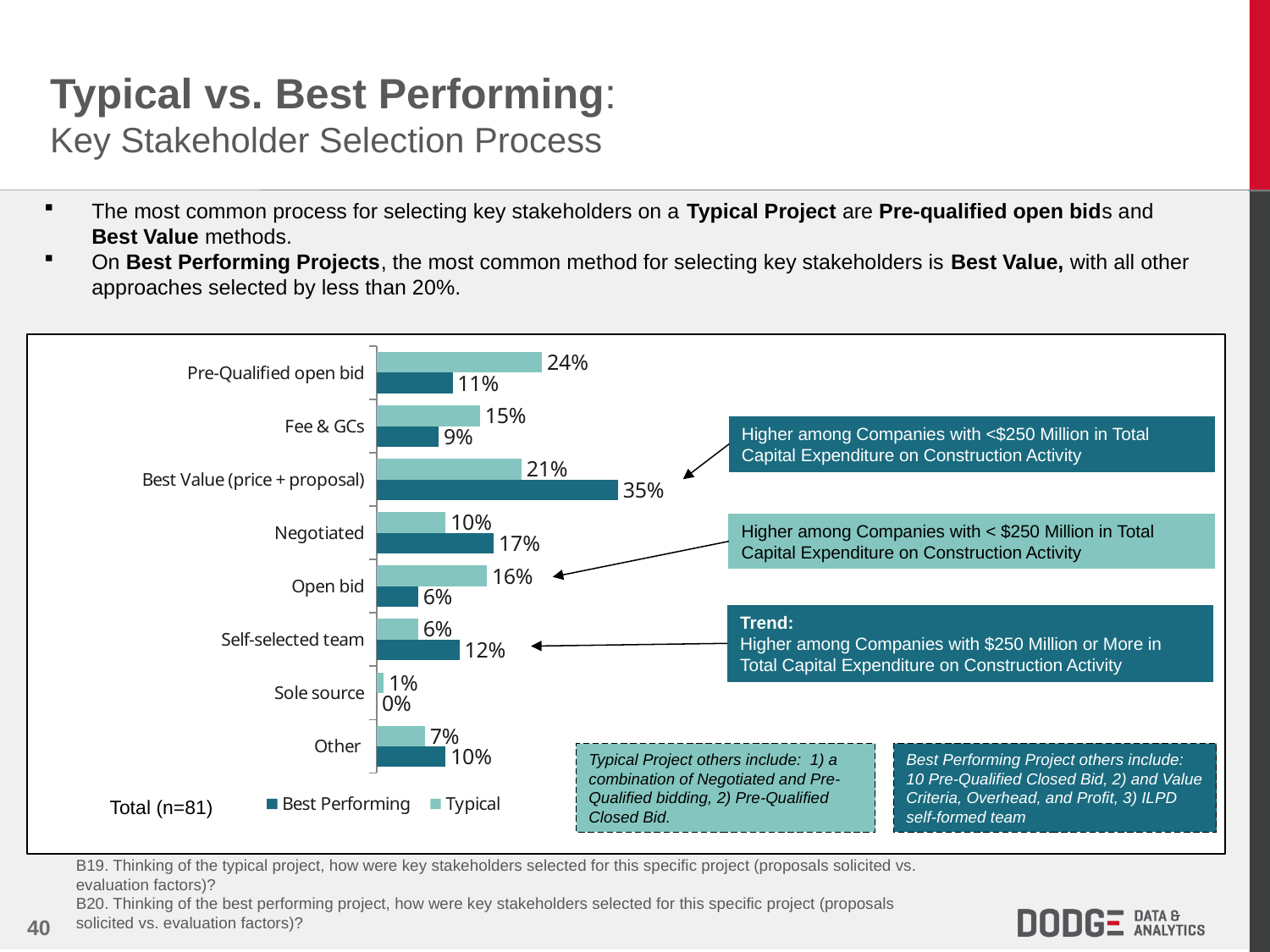
What is the Typical value for Open bid? 16% What is the Best Performing value for Best Value (price + proposal)? 35% What is the Best Performing value for Negotiated? 17% Which category has the lowest Typical value? Sole source What is the Typical value for Pre-Qualified open bid? 24% Which is larger for Self-selected team, the Best Performing value or the Typical value? Best Performing Which category has the highest Best Performing value? Best Value (price + proposal) What is the sample size shown below the chart? n=81 How many series does the legend list? 2 How many categories are shown on the chart? 8 What is the difference between the Best Performing and Typical values for Best Value (price + proposal)? 14% What kind of chart is shown on the slide? Bar chart